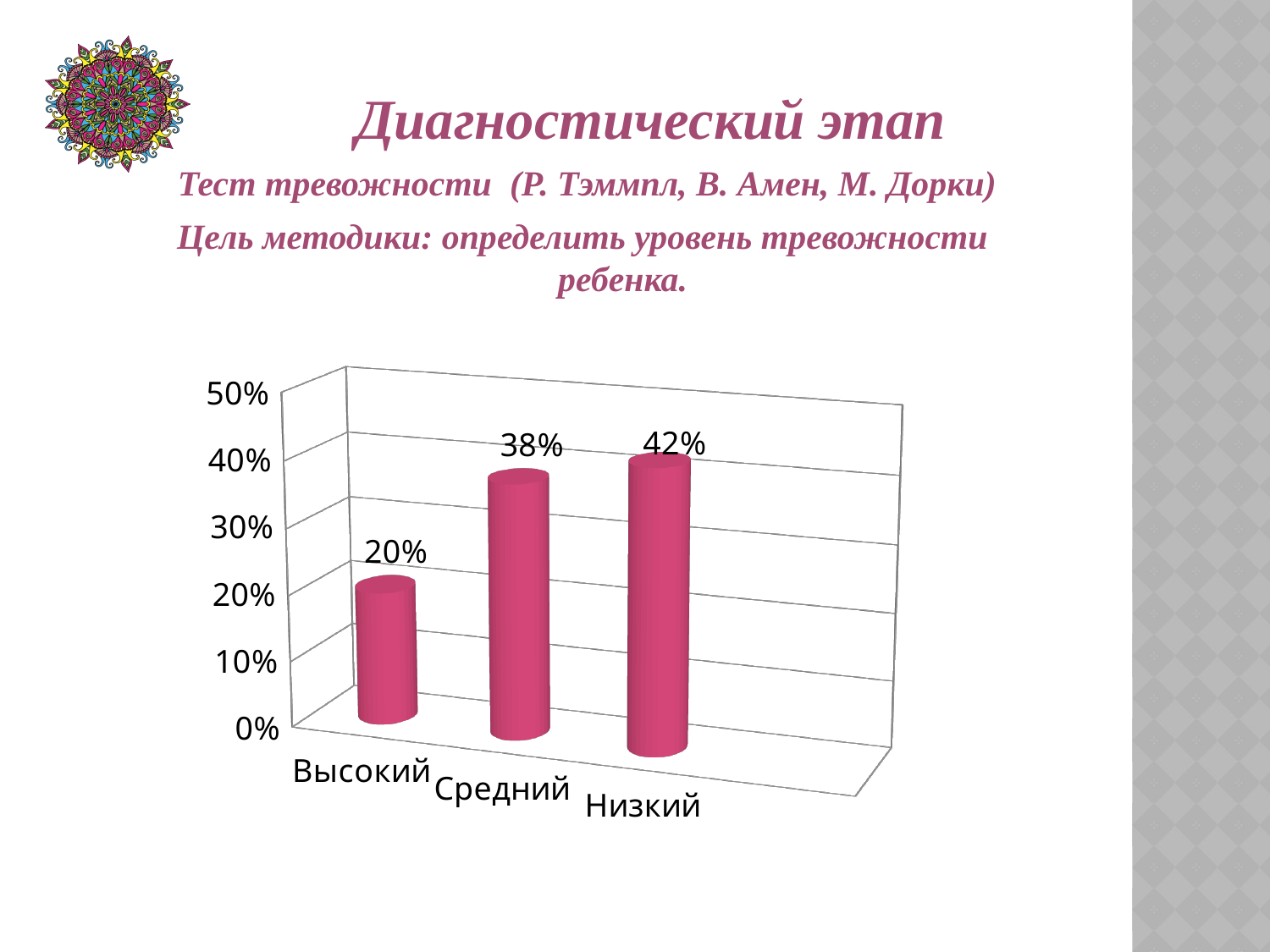
What kind of chart is shown on the slide? bar chart Which category has the lowest value? Высокий What is the value for Высокий? 20% What is the difference between the values for Низкий and Высокий? 22% What is the difference between the values for Средний and Высокий? 18% Is the value for Средний greater or less than 30%? greater Do the values rise or fall from Высокий to Низкий along the x axis? rise What is the value for Низкий? 42% How many categories are shown on the x axis? 3 What is the value for Средний? 38% Which is larger, the value for Средний or the value for Высокий? Средний Which category has the highest value? Низкий